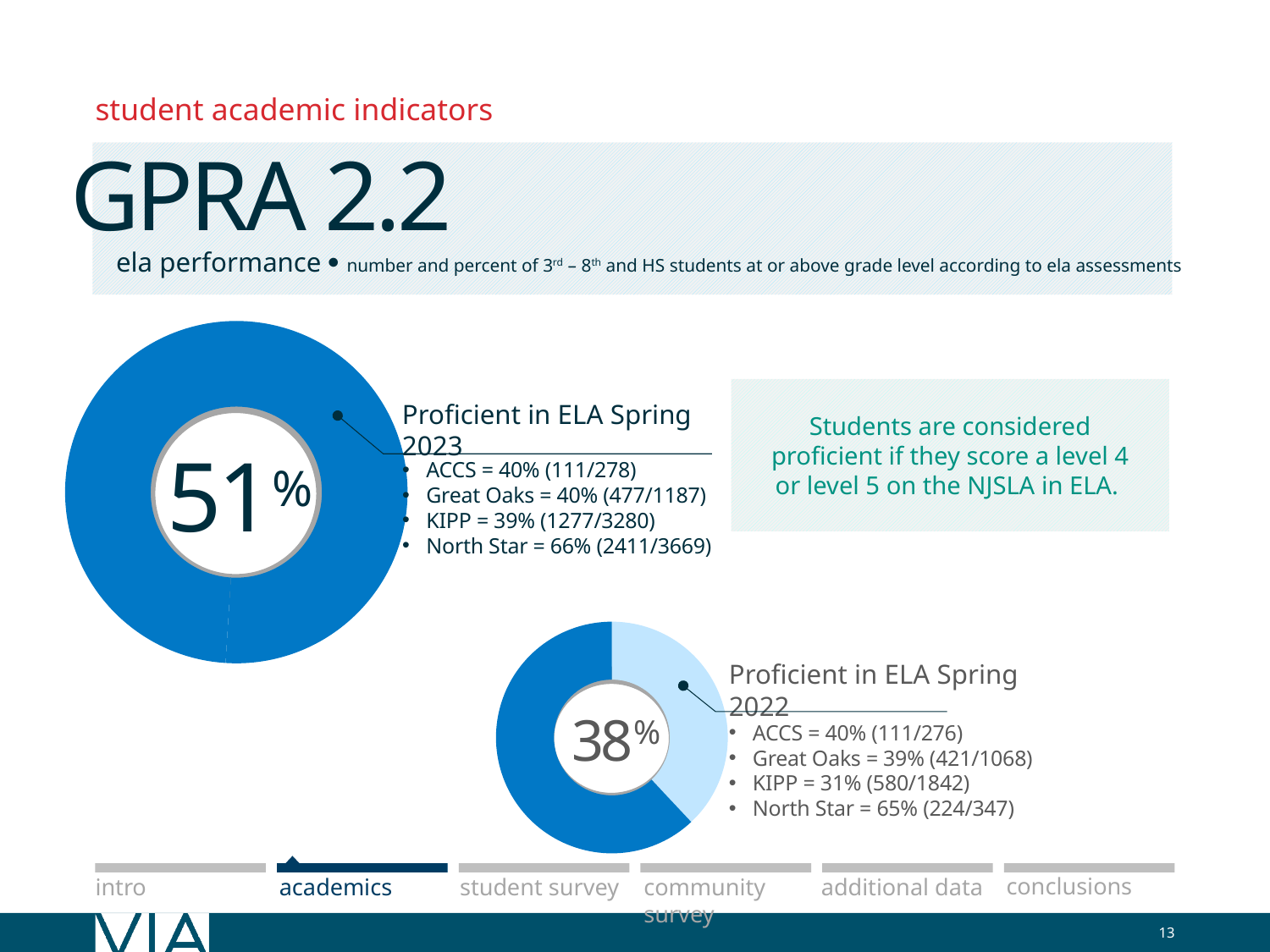
In the Proficient in ELA Spring 2022 donut chart, what share of the ring is not covered by the 38% proficient segment? 62% In the Proficient in ELA Spring 2023 callout, which school has the highest proficiency percentage? North Star (66%) What is the difference in percentage points between the Spring 2023 donut value (51%) and the Spring 2022 donut value (38%)? 13 percentage points Which donut chart shows the higher proficiency percentage, Spring 2023 or Spring 2022? Spring 2023 How many donut charts are shown on the slide? 2 Did the overall ELA proficiency percentage rise or fall from Spring 2022 to Spring 2023? Rise What percentage is shown in the centre of the Proficient in ELA Spring 2023 donut chart? 51% What is the title of the callout attached to the donut chart showing 38%? Proficient in ELA Spring 2022 What kind of chart is used to show the ELA proficiency percentages on this slide? Donut (pie) chart What percentage is shown in the centre of the Proficient in ELA Spring 2022 donut chart? 38% In the Proficient in ELA Spring 2022 callout, which school has the lowest proficiency percentage? KIPP (31%) In the Proficient in ELA Spring 2022 donut chart, what colour is the segment representing the 38%? Light blue